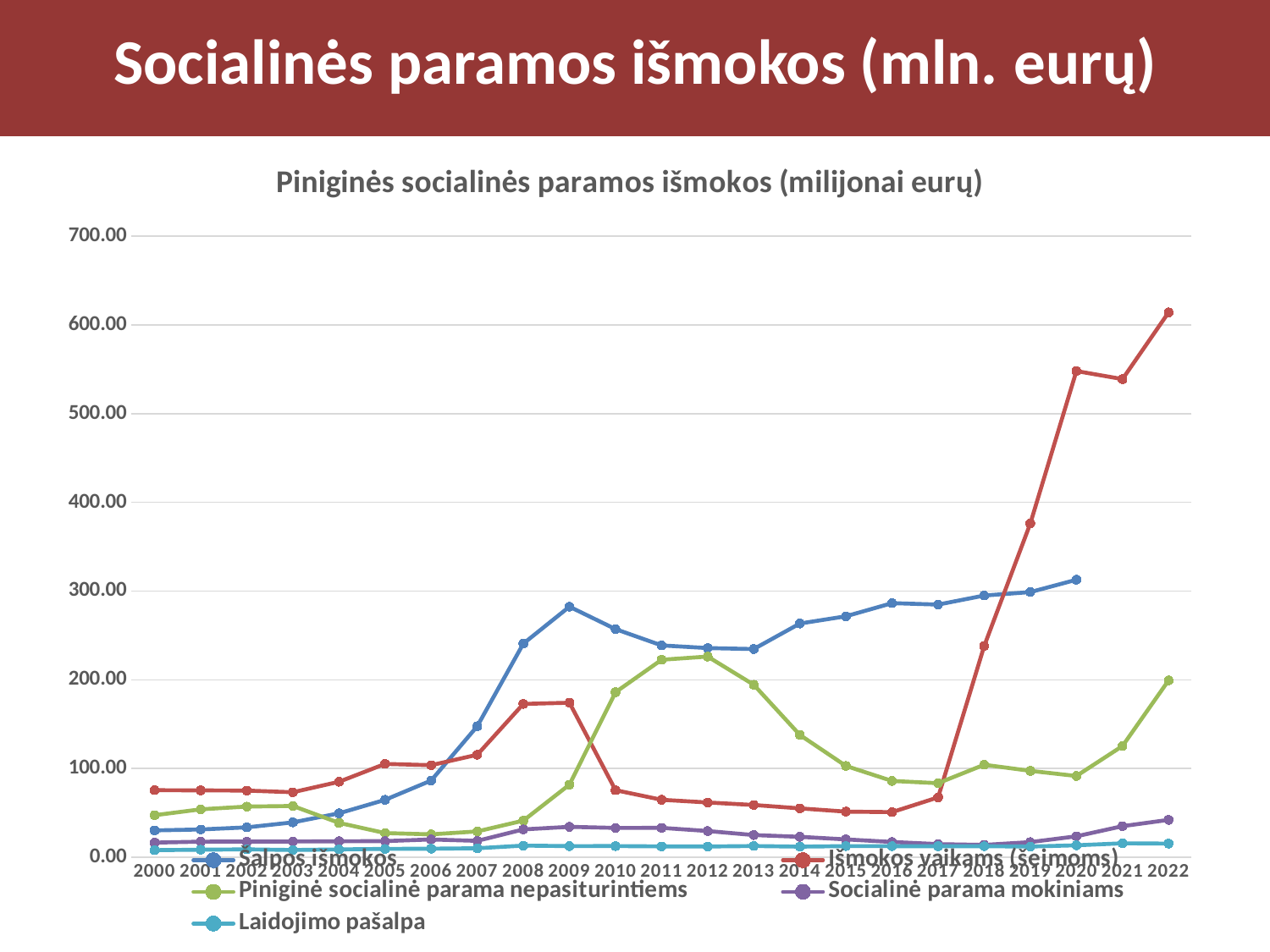
What kind of chart is shown on the slide? line chart What is the title of the chart? Piniginės socialinės paramos išmokos (milijonai eurų) In which year does the Išmokos vaikams (šeimoms) series reach its highest value? 2022 Is the value for Išmokos vaikams (šeimoms) in 2010 greater or less than 100? less Does the Išmokos vaikams (šeimoms) series rise or fall from 2017 to 2020? rise Which series has the highest value in 2022? Išmokos vaikams (šeimoms) How many years are shown along the x axis? 23 Is the value for Išmokos vaikams (šeimoms) in 2022 greater or less than 500? greater In 2009, which is larger: Šalpos išmokos or Išmokos vaikams (šeimoms)? Šalpos išmokos How many series does the legend list? 5 Which series has the lowest values across the whole period? Laidojimo pašalpa Is the value for Piniginė socialinė parama nepasiturintiems in 2012 greater or less than 200? greater